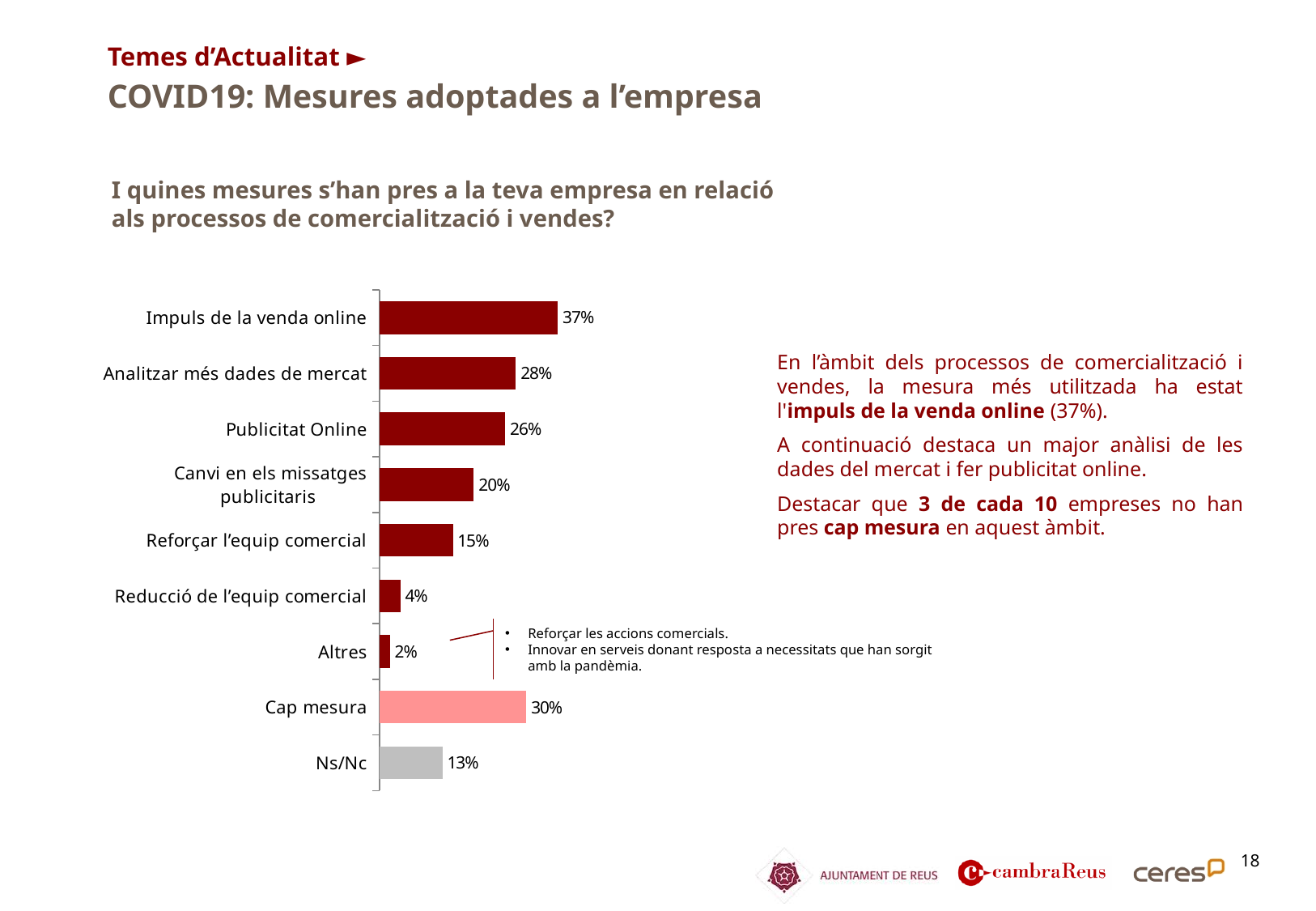
What percentage is shown for 'Reforçar l'equip comercial'? 15% What is the value for 'Ns/Nc'? 13% What is the difference between 'Analitzar més dades de mercat' and 'Publicitat Online'? 2% Which is larger: 'Canvi en els missatges publicitaris' or 'Reducció de l'equip comercial'? Canvi en els missatges publicitaris Which category has the lowest value in the chart? Altres Which bar in the chart is coloured grey? Ns/Nc Which category has the highest value in the chart? Impuls de la venda online What percentage of companies reported 'Impuls de la venda online'? 37% How many categories are shown in the chart? 9 What is the difference between 'Impuls de la venda online' and 'Cap mesura'? 7% What type of chart is shown on the slide? Bar chart What is the value shown for 'Cap mesura'? 30%